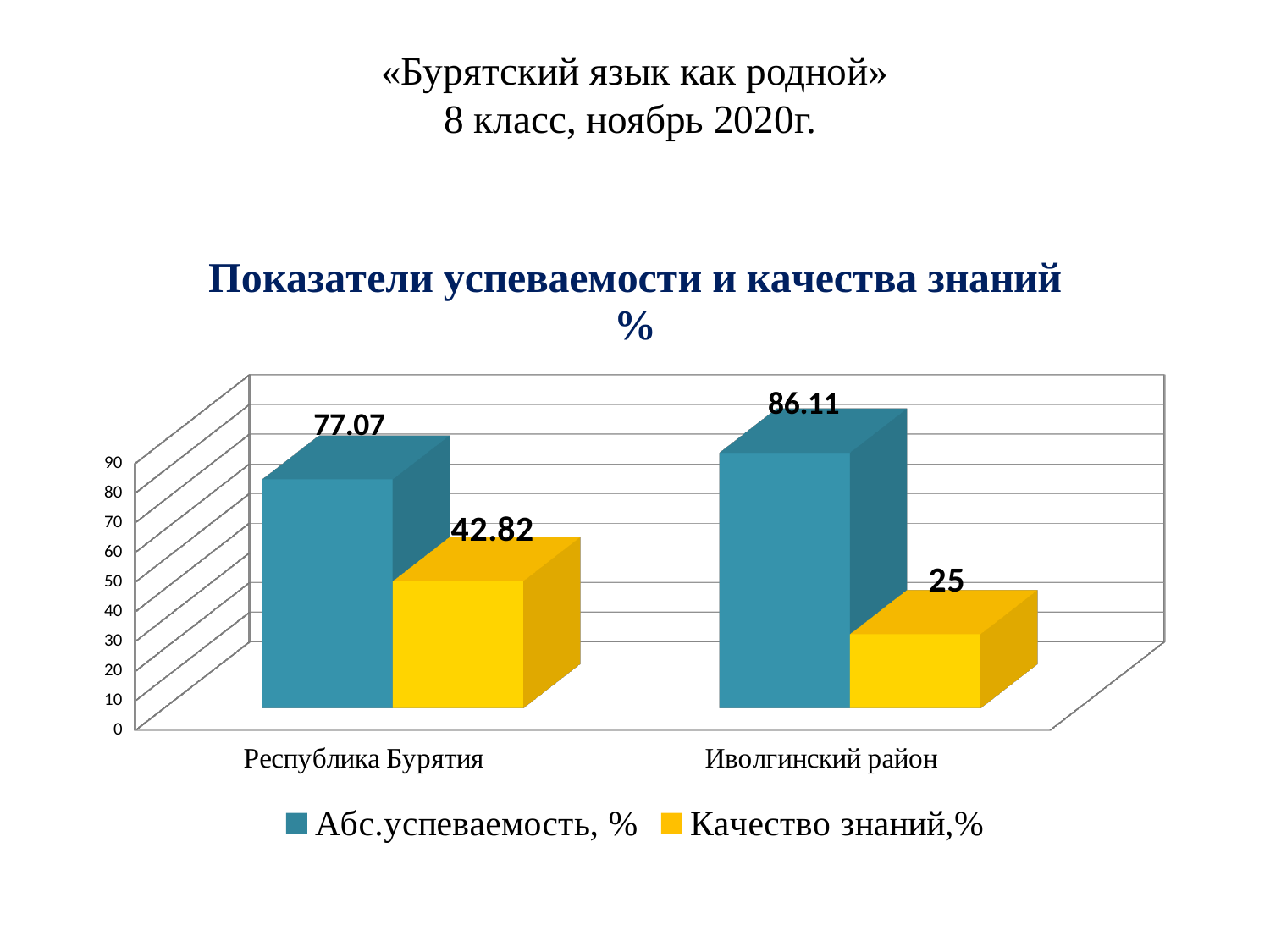
Which category has the higher Абс.успеваемость, % value? Иволгинский район What is the value of Абс.успеваемость, % for Иволгинский район? 86.11 What is the value of Качество знаний,% for Республика Бурятия? 42.82 What is the difference between the Абс.успеваемость, % values for Иволгинский район and Республика Бурятия? 9.04 What is the difference between the Качество знаний,% values for Республика Бурятия and Иволгинский район? 17.82 Which category has the lower Качество знаний,% value? Иволгинский район How many categories are shown on the x axis? 2 What is the value of Абс.успеваемость, % for Республика Бурятия? 77.07 What is the value of Качество знаний,% for Иволгинский район? 25 Is the Качество знаний,% value for Республика Бурятия larger or smaller than the Качество знаний,% value for Иволгинский район? larger How many series does the legend list? 2 What kind of chart is shown on the slide? bar chart